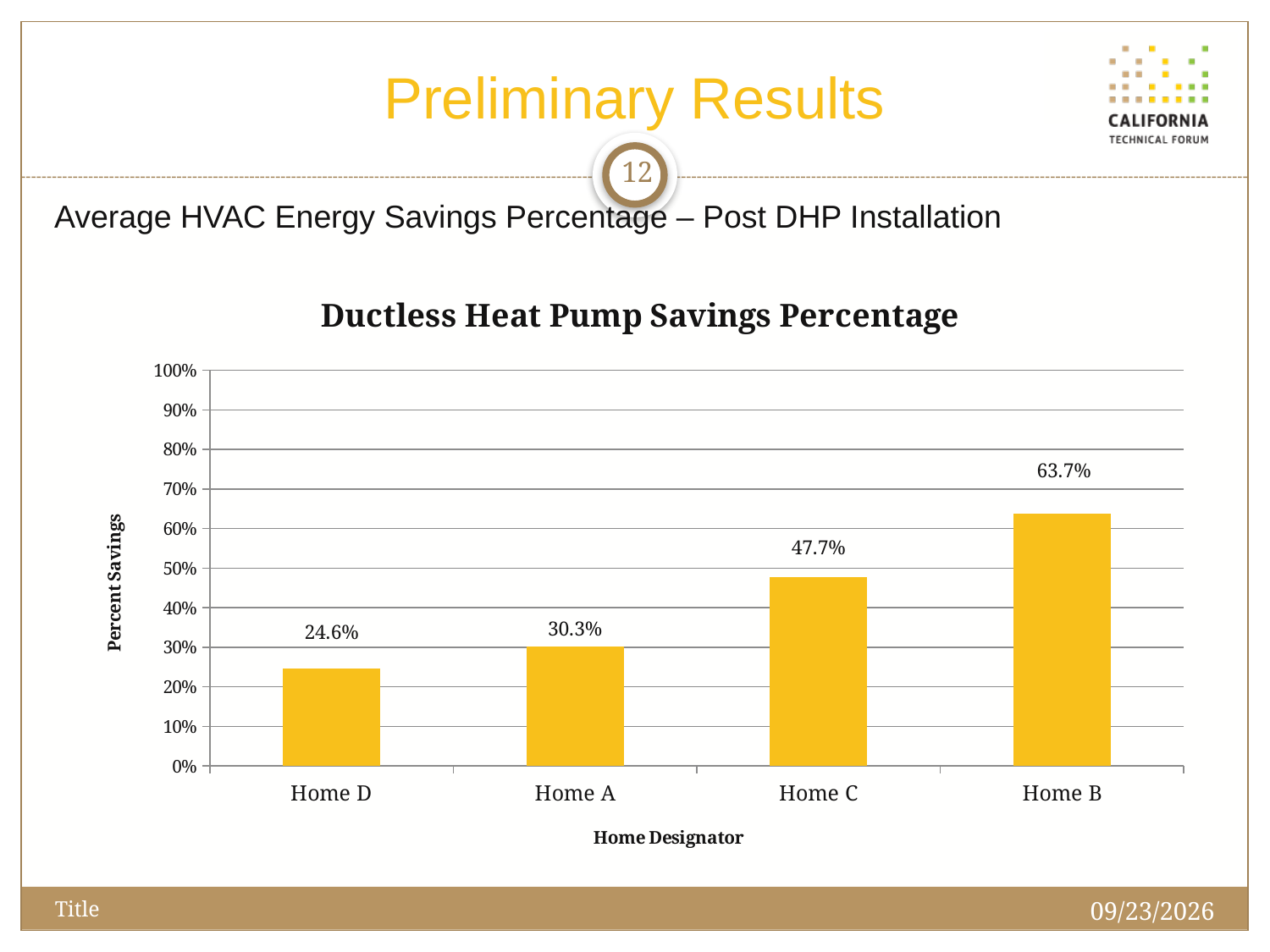
What is the title of the chart? Ductless Heat Pump Savings Percentage Is the value for Home B greater or less than 50%? greater What is the difference in savings percentage between Home B and Home D? 39.1% Which has a higher savings percentage, Home A or Home C? Home C What is the savings percentage for Home B? 63.7% Which home has the lowest savings percentage? Home D Which home has the highest savings percentage? Home B How many homes are shown on the chart? 4 What kind of chart is shown on the slide? Bar chart What is the savings percentage for Home C? 47.7% What is the savings percentage for Home D? 24.6% What is the difference in savings percentage between Home C and Home A? 17.4%